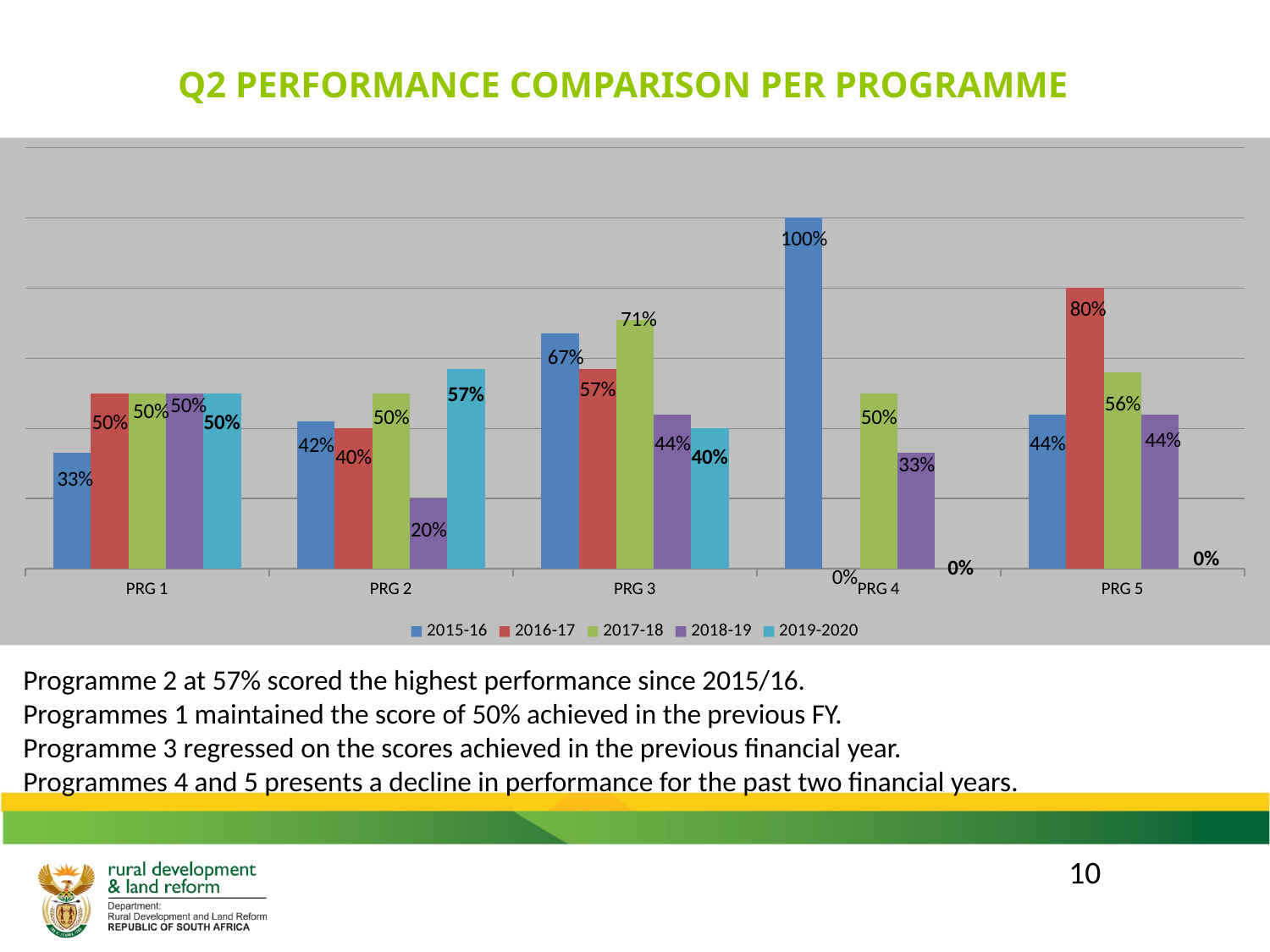
What type of chart is shown on the slide? bar chart What is the value for PRG 5 in 2016-17? 80% What is the difference between the 2017-18 and 2018-19 values for PRG 3? 27% What is the value for PRG 1 in 2015-16? 33% What is the title of the chart? Q2 PERFORMANCE COMPARISON PER PROGRAMME What is the value for PRG 3 in 2017-18? 71% Which programme has the lowest value in the 2018-19 series? PRG 2 How many programme categories are shown on the x axis? 5 What is the value for PRG 2 in 2019-2020? 57% How many series does the legend list? 5 Which programme has the highest value in the 2015-16 series? PRG 4 Which is larger for PRG 5: the 2015-16 value or the 2017-18 value? 2017-18